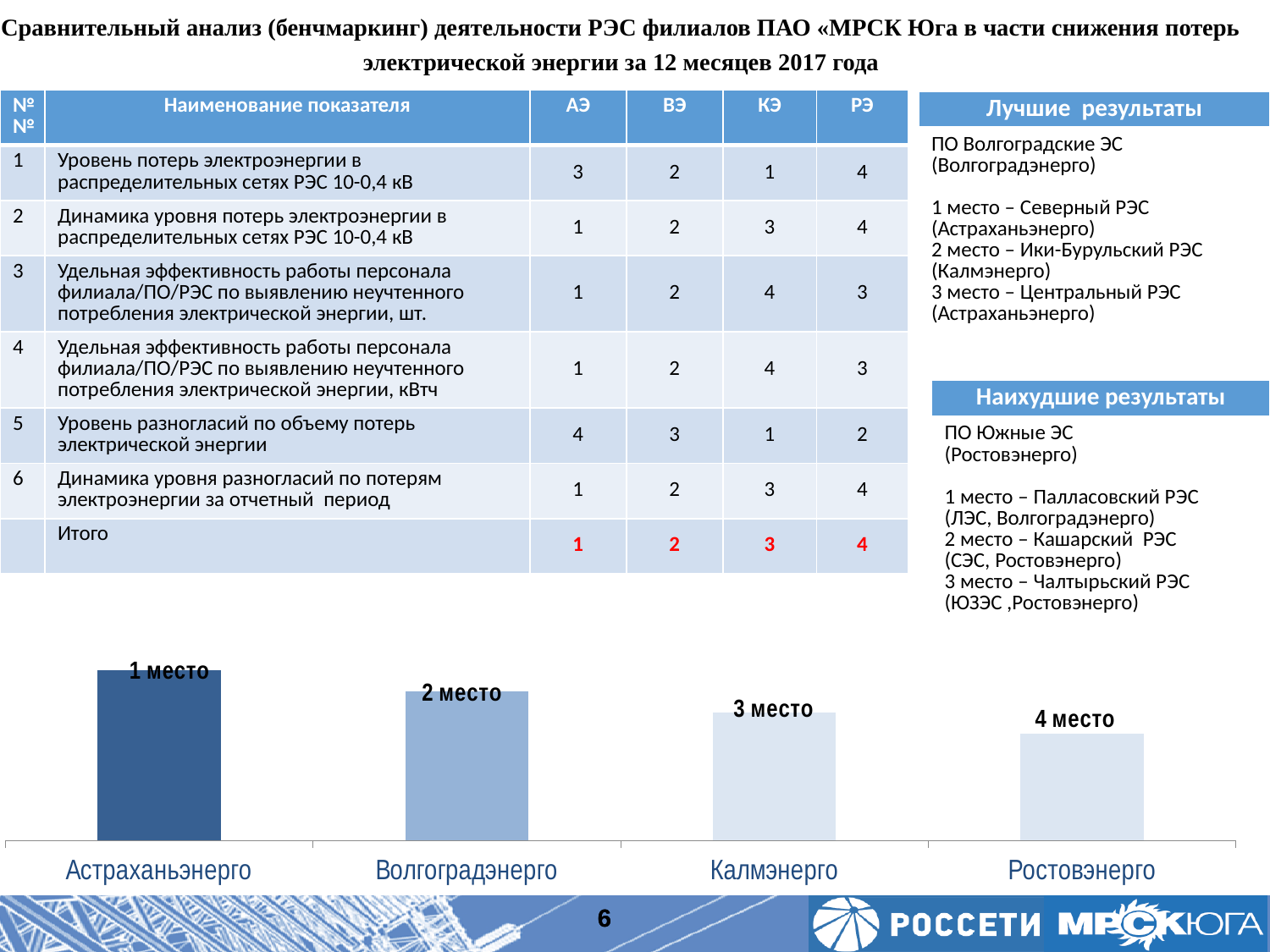
How many bars (categories) does the chart at the bottom of the slide show? 4 What label is printed on the bar for Ростовэнерго? 4 место What kind of chart is shown at the bottom of the slide? bar chart Which bar is taller, Волгоградэнерго or Калмэнерго? Волгоградэнерго What label is printed on the bar for Астраханьэнерго? 1 место Which category has the tallest bar in the chart? Астраханьэнерго Which category has the shortest bar in the chart? Ростовэнерго Which category is placed furthest to the right on the x axis of the chart? Ростовэнерго What label is printed on the bar for Волгоградэнерго? 2 место What label is printed on the bar for Калмэнерго? 3 место Which bar in the chart is coloured the darkest blue? Астраханьэнерго Do the bars rise or fall from left to right along the x axis? fall